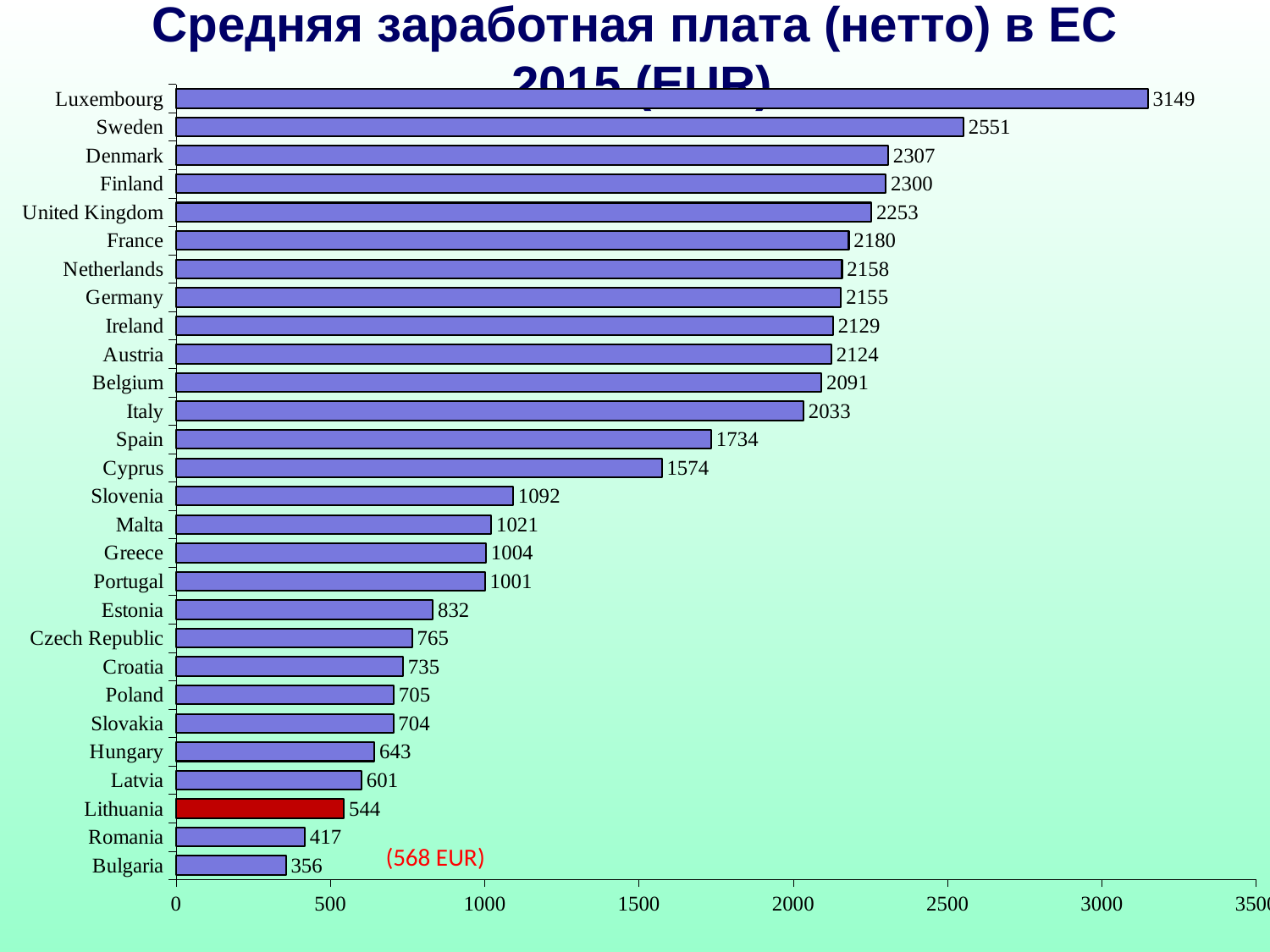
What is the value for Luxembourg? 3149 What kind of chart is shown on the slide? bar chart What is the value for Germany? 2155 What is the value for Lithuania? 544 What is the difference between the values for Lithuania and Latvia? 57 How many countries are shown in the chart? 28 What is the difference between the values for Sweden and Denmark? 244 Which country's bar is coloured red instead of blue? Lithuania Is the value for Estonia greater or less than 1000? less Which is larger, the value for Spain or the value for Cyprus? Spain Which country has the highest value? Luxembourg Which country has the lowest value? Bulgaria